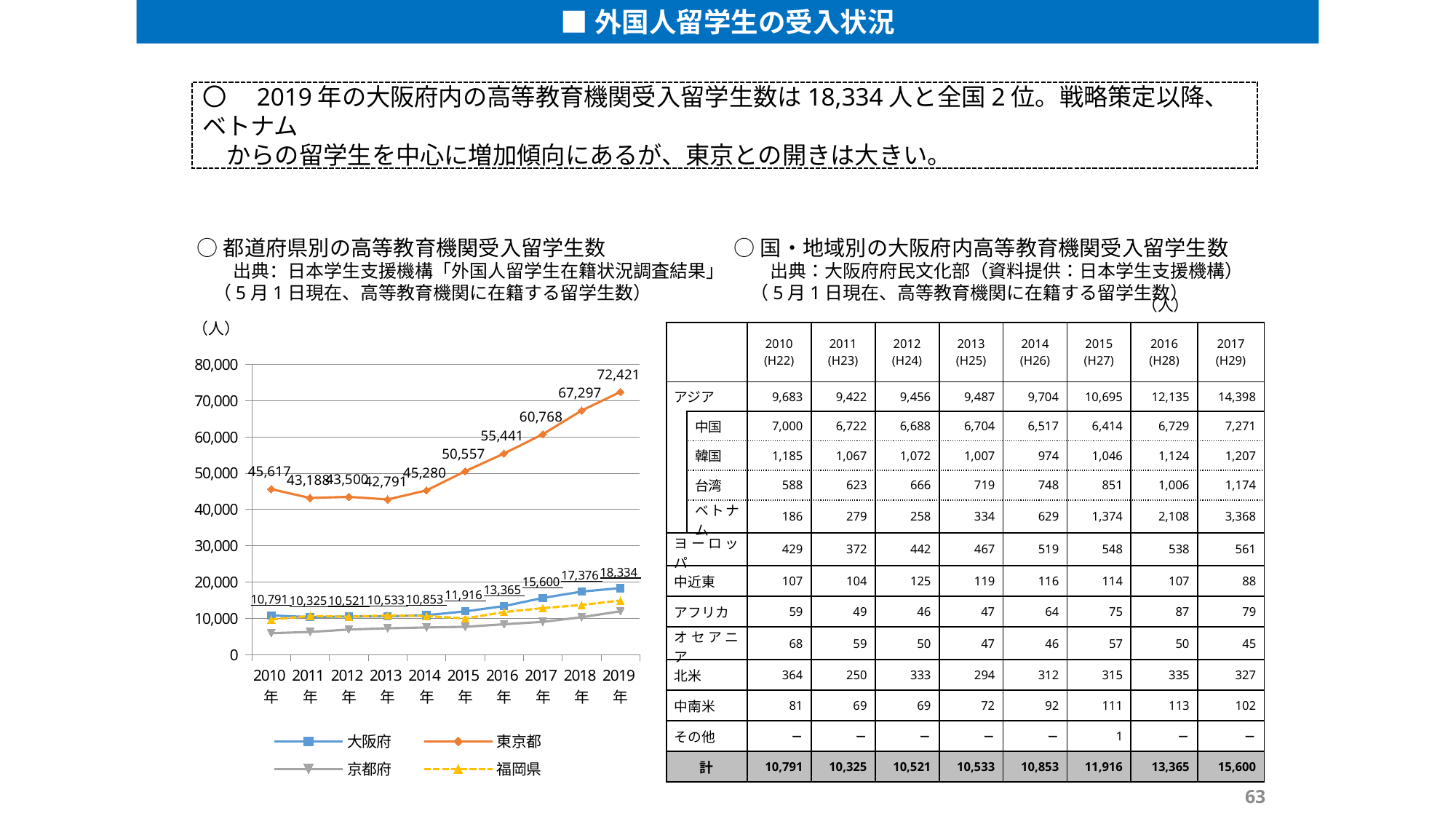
What is the value for 東京都 in 2019年? 72,421 What is the difference between the 東京都 and 大阪府 values in 2019年? 54,087 Is the value for 京都府 in 2019年 greater or less than 20,000? less In which year is the value for 大阪府 highest? 2019年 How many years are plotted along the x axis of the chart? 10 What is the value for 大阪府 in 2017年? 15,600 Does the value for 東京都 rise or fall from 2014年 to 2019年? rise How many series does the chart legend list? 4 Which series has the larger value in 2015年, 東京都 or 大阪府? 東京都 In which year is the value for 東京都 lowest? 2013年 What is the value for 大阪府 in 2010年? 10,791 What kind of chart is shown on the slide? line chart